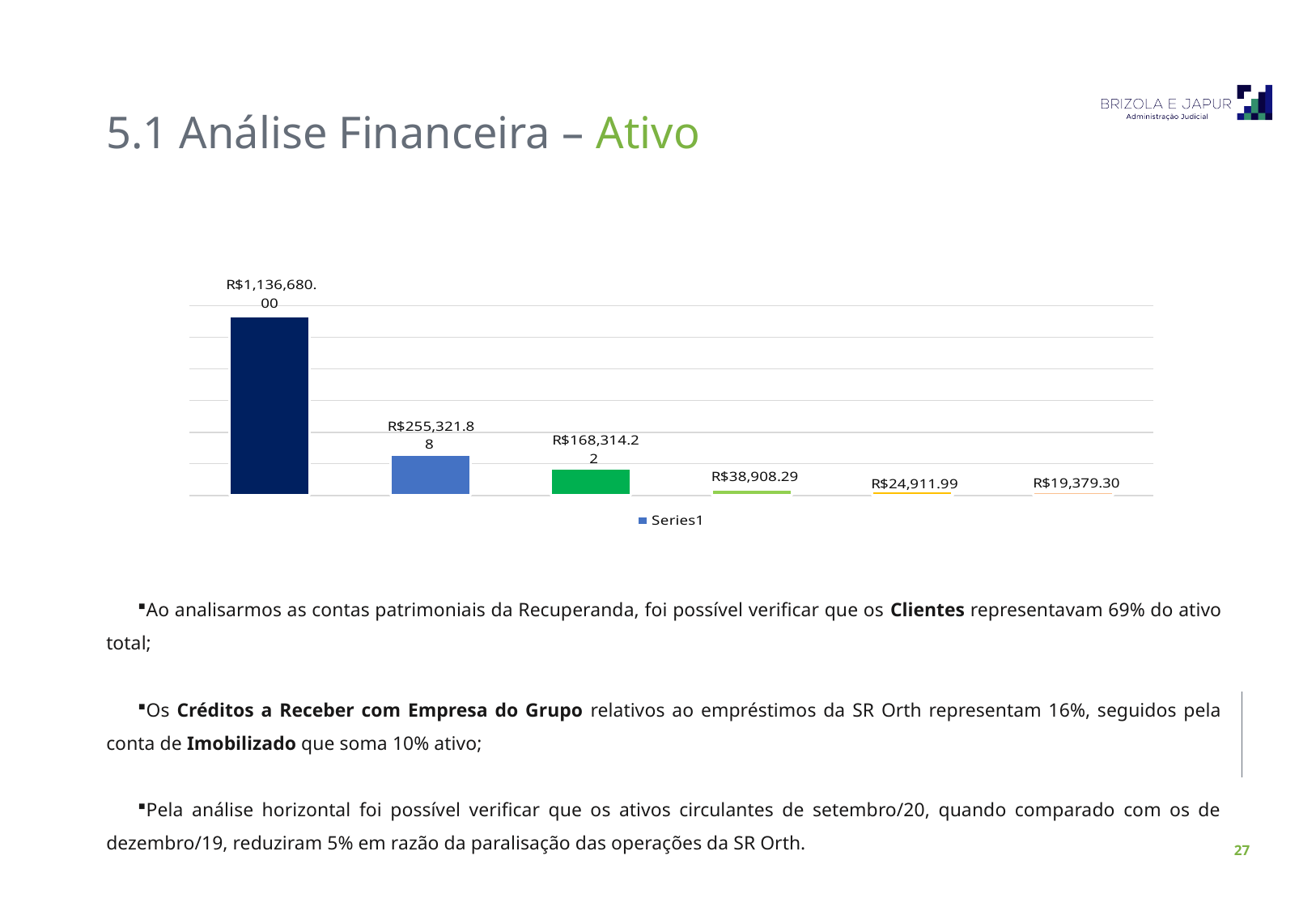
How many series does the chart legend list? 1 Do the bar values rise or fall from left to right across the chart? fall How many bars are plotted in the chart? 6 What type of chart is shown on the slide? bar chart What is the highest value shown in the chart? R$1,136,680.00 What is the value shown on the second bar from the left? R$255,321.88 What is the value shown on the green (third) bar? R$168,314.22 What is the value shown on the fifth bar from the left? R$24,911.99 What is the value shown on the first (leftmost, dark blue) bar? R$1,136,680.00 What is the name of the series shown in the chart legend? Series1 What is the lowest value shown in the chart? R$19,379.30 What is the value shown on the last (rightmost) bar? R$19,379.30